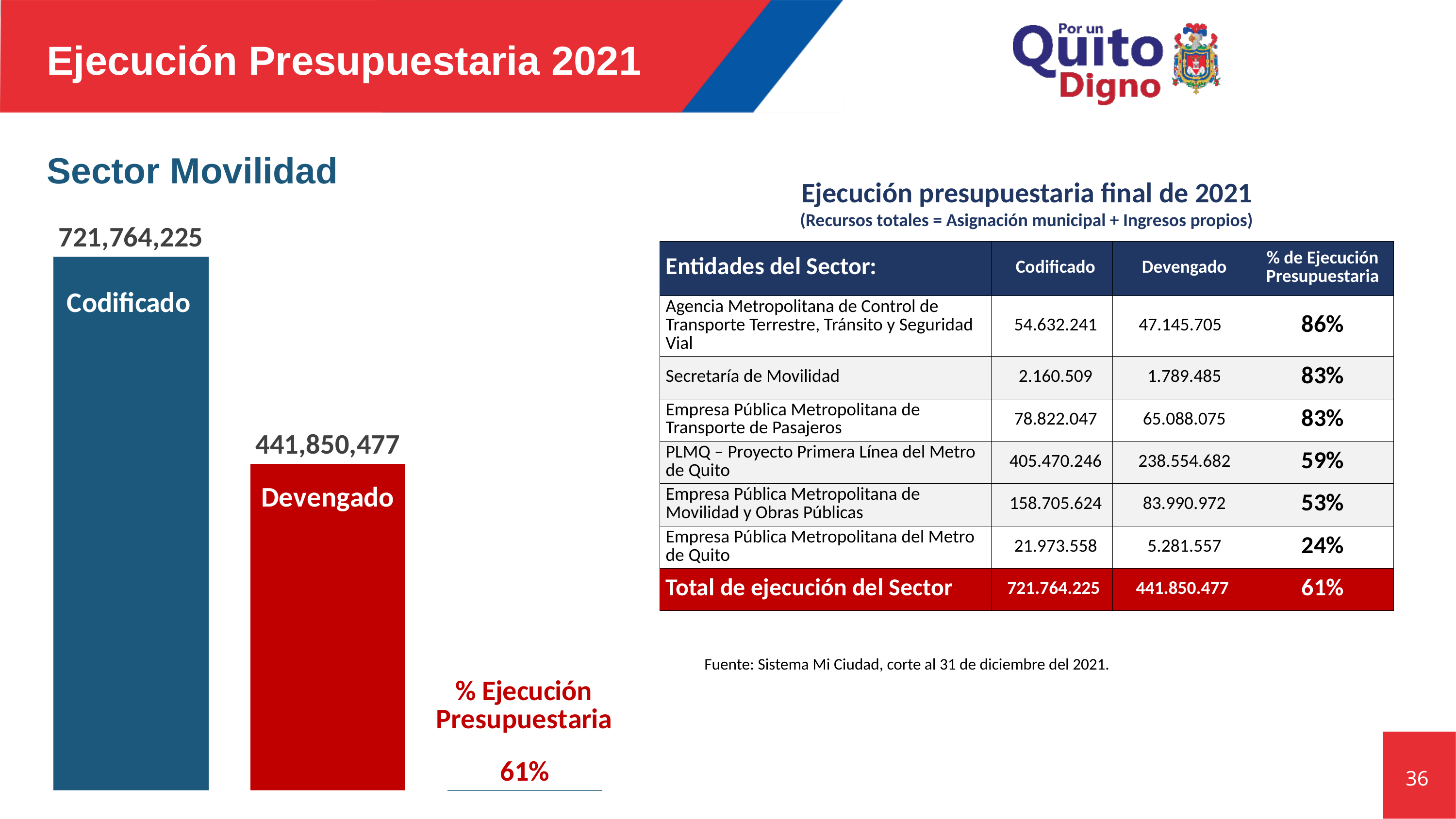
What is the value of the Devengado bar in the Sector Movilidad chart? 441,850,477 Which bar in the Sector Movilidad chart is the lowest? Devengado In the Sector Movilidad chart, is the Codificado value larger or smaller than the Devengado value? larger What % Ejecución Presupuestaria is shown next to the bars in the Sector Movilidad chart? 61% What colour is the Codificado bar in the Sector Movilidad chart? blue What kind of chart is shown under the heading Sector Movilidad? bar chart Do the bar values in the Sector Movilidad chart rise or fall from Codificado to Devengado? fall How many bars are plotted in the Sector Movilidad chart? 2 What colour is the Devengado bar in the Sector Movilidad chart? red What is the difference between the Codificado and Devengado values in the Sector Movilidad chart? 279,913,748 Which bar in the Sector Movilidad chart is the highest? Codificado What is the value of the Codificado bar in the Sector Movilidad chart? 721,764,225